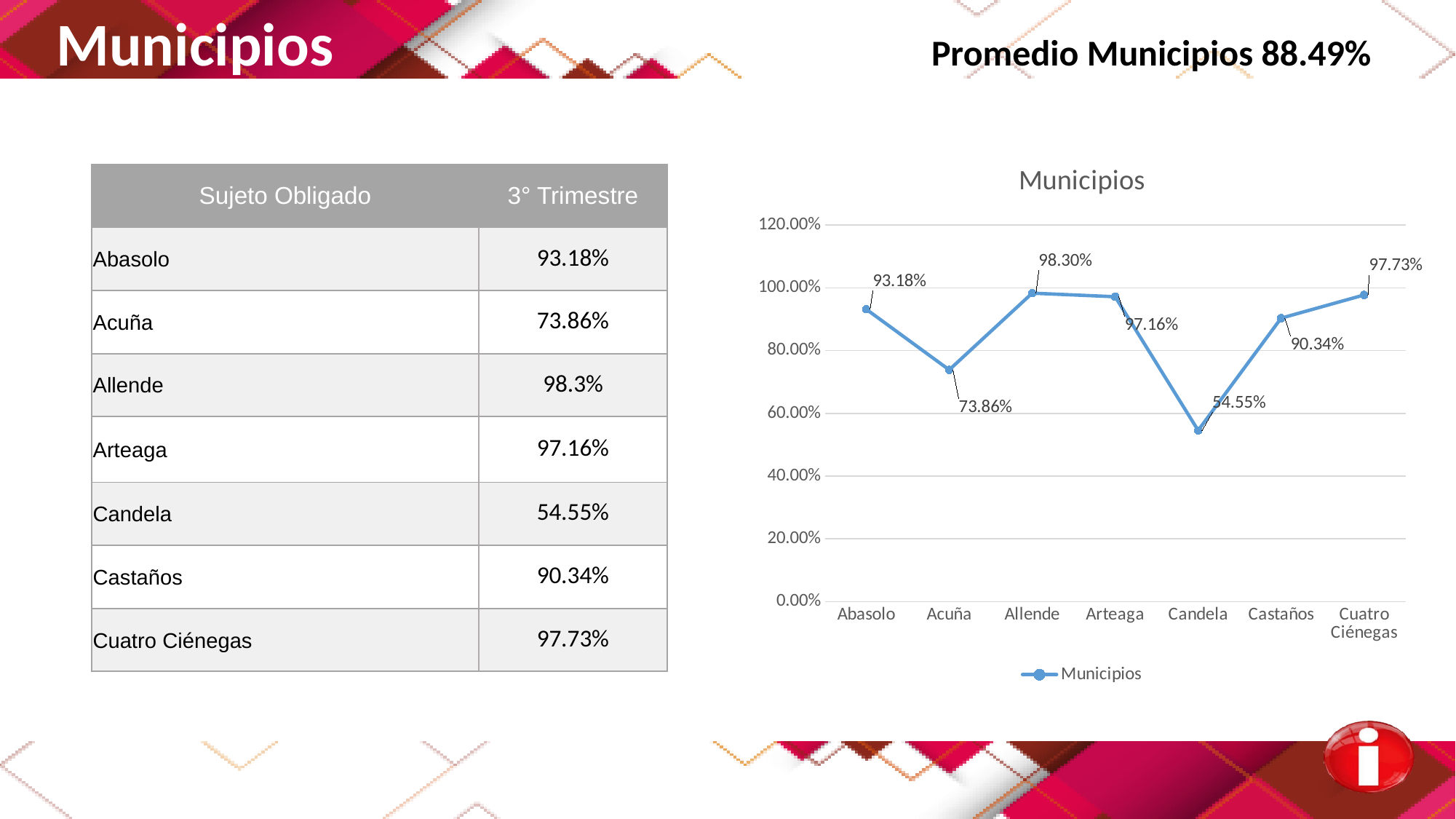
Which municipality has the highest value in the Municipios chart? Allende What is the value for Castaños in the Municipios chart? 90.34% What kind of chart is the Municipios chart? line chart Which is larger in the Municipios chart, the value for Cuatro Ciénegas or the value for Castaños? Cuatro Ciénegas What is the value for Candela in the Municipios chart? 54.55% What is the title of the chart on the slide? Municipios How many series does the legend of the Municipios chart list? 1 What is the value for Abasolo in the Municipios chart? 93.18% Is the value for Acuña in the Municipios chart greater or less than 80.00%? less How many municipalities are plotted in the Municipios chart? 7 What is the difference between the values for Allende and Acuña in the Municipios chart? 24.44% Which municipality has the lowest value in the Municipios chart? Candela